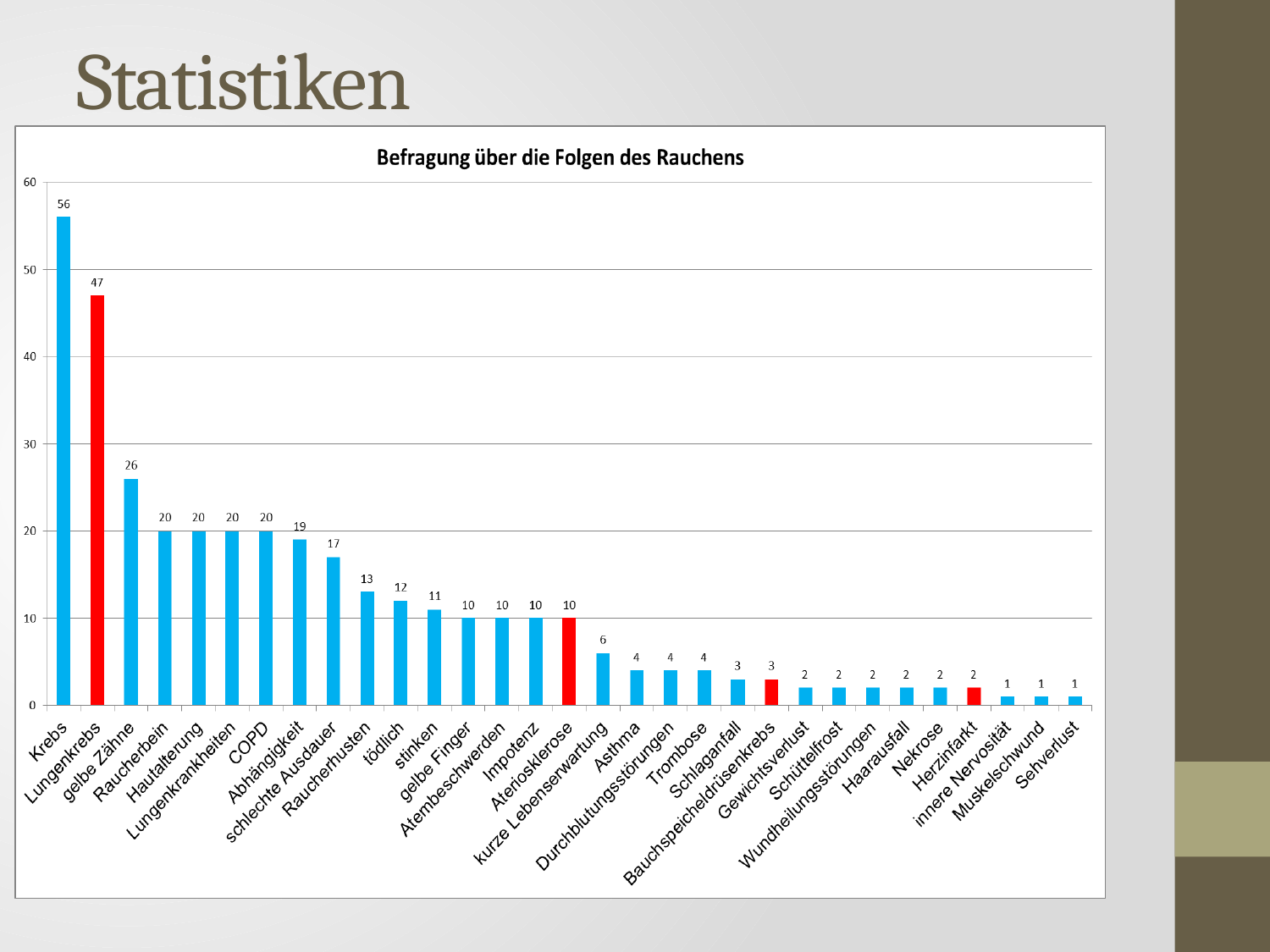
What is the value for kurze Lebenserwartung? 6 How many categories are shown on the x axis? 31 Is the value for gelbe Zähne greater or less than 30? less Which is larger, the value for schlechte Ausdauer or the value for tödlich? schlechte Ausdauer What is the value for Krebs? 56 What is the difference between the values for gelbe Zähne and Raucherhusten? 13 What is the value for Abhängigkeit? 19 Which category has the highest value? Krebs What kind of chart is shown on the slide? bar chart What is the value for Lungenkrebs? 47 What is the difference between the values for Krebs and Lungenkrebs? 9 What is the title of the chart? Befragung über die Folgen des Rauchens